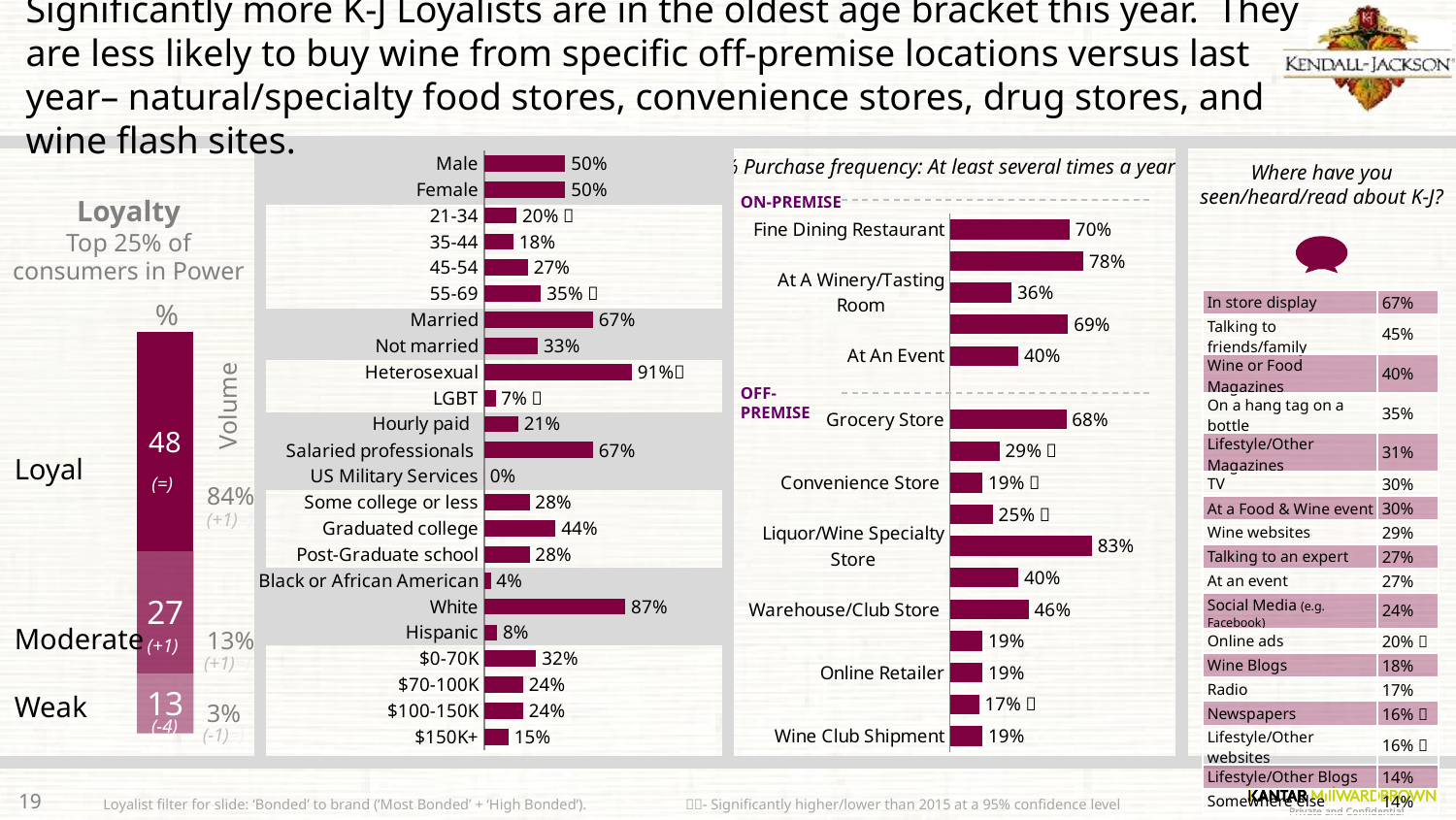
In the Loyalty stacked bar chart, what is the value for the Moderate segment? 27 What kind of chart is the demographics chart in the middle-left of the slide? Bar chart In the purchase frequency bar chart, what is the value for Fine Dining Restaurant? 70% In the purchase frequency bar chart, what is the difference between Grocery Store and Convenience Store? 49% In the demographics bar chart, which is larger: Graduated college or Post-Graduate school? Graduated college In the demographics bar chart, which age group (21-34, 35-44, 45-54, 55-69) has the lowest value? 35-44 In the demographics bar chart, what is the value for US Military Services? 0% In the purchase frequency bar chart, which is larger: Grocery Store or Warehouse/Club Store? Grocery Store In the demographics bar chart, what is the value for Heterosexual? 91% In the purchase frequency bar chart, what is the value for Liquor/Wine Specialty Store? 83% In the demographics bar chart, what is the value for the 55-69 age group? 35% In the demographics bar chart, what is the difference between Married and Not married? 34%